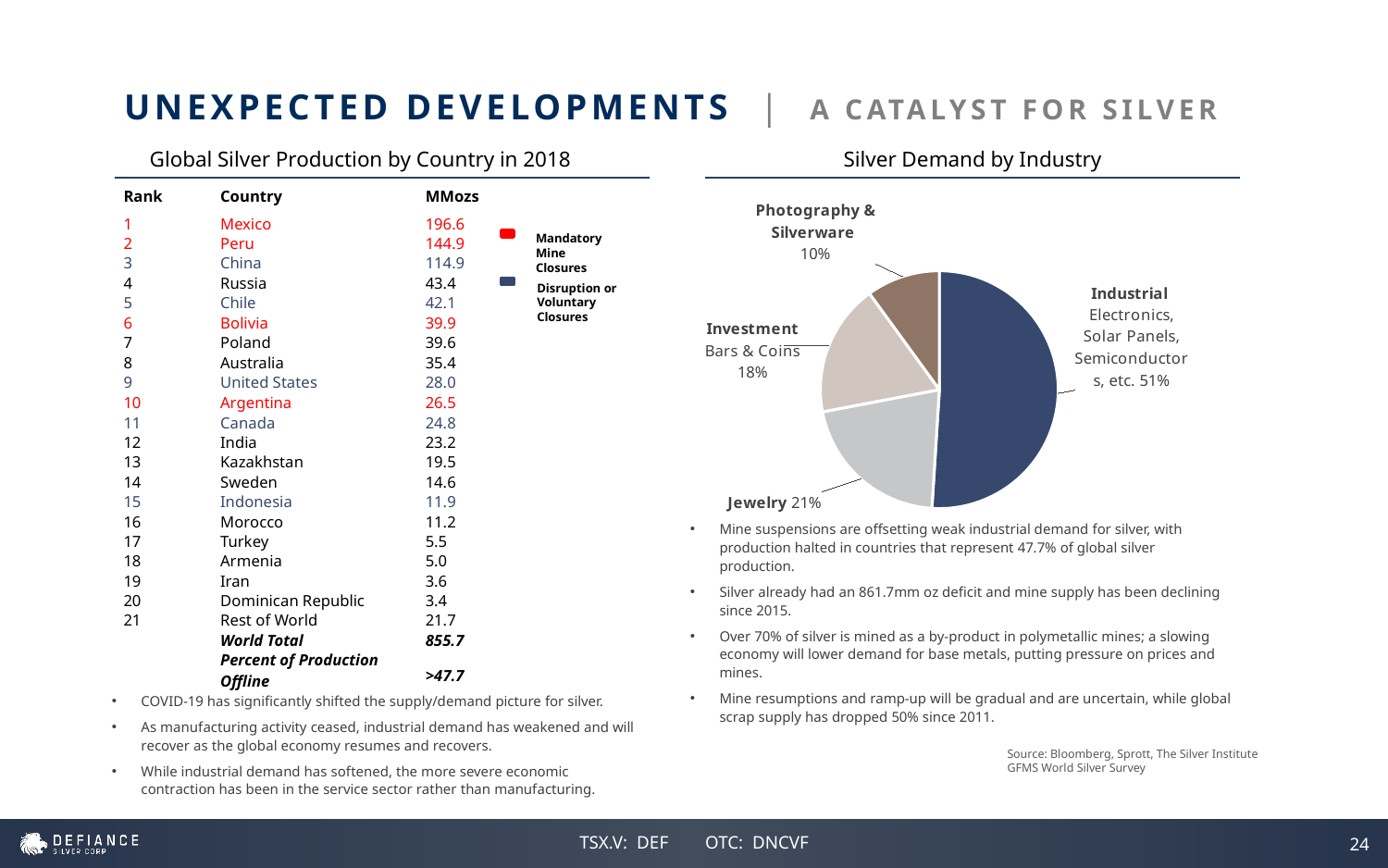
In the Silver Demand by Industry pie chart, how many percentage points larger is the Industrial share than the Jewelry share? 30 What is the title of the pie chart on the right side of the slide? Silver Demand by Industry In the Silver Demand by Industry pie chart, what is the combined share of Jewelry and Investment Bars & Coins? 39% In the Silver Demand by Industry pie chart, which category has the smallest share? Photography & Silverware In the Silver Demand by Industry pie chart, which is larger: Jewelry or Investment Bars & Coins? Jewelry In the Silver Demand by Industry pie chart, which category has the largest share? Industrial In the Silver Demand by Industry pie chart, what share of demand is Photography & Silverware? 10% In the Silver Demand by Industry pie chart, what share of demand is Industrial (Electronics, Solar Panels, Semiconductors, etc.)? 51% What kind of chart is shown under "Silver Demand by Industry"? pie chart How many slices does the Silver Demand by Industry pie chart have? 4 In the Silver Demand by Industry pie chart, what share of demand is Investment (Bars & Coins)? 18% In the Silver Demand by Industry pie chart, what share of demand is Jewelry? 21%